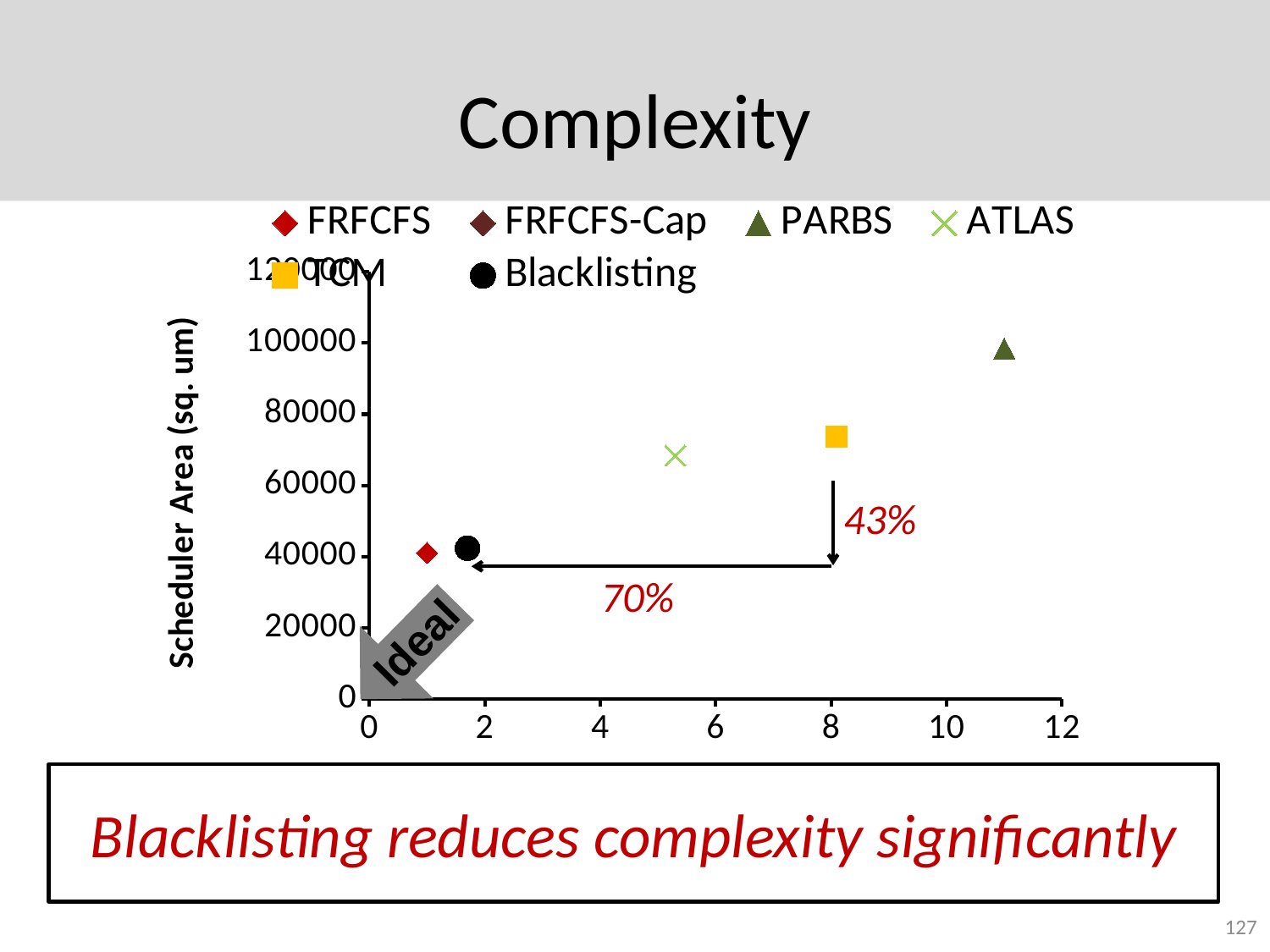
What kind of chart is shown on the slide? scatter chart What percentage reduction is annotated on the horizontal arrow from TCM to Blacklisting? 70% How many series does the legend list? 6 Is the Scheduler Area for FRFCFS greater or less than 60000? less Is the Scheduler Area for PARBS greater or less than 80000? greater Which has a larger Scheduler Area, TCM or Blacklisting? TCM Is the Scheduler Area for Blacklisting greater or less than 60000? less Which scheduler has the highest Scheduler Area? PARBS Which has a larger Scheduler Area, PARBS or TCM? PARBS What is the label of the y axis? Scheduler Area (sq. um)